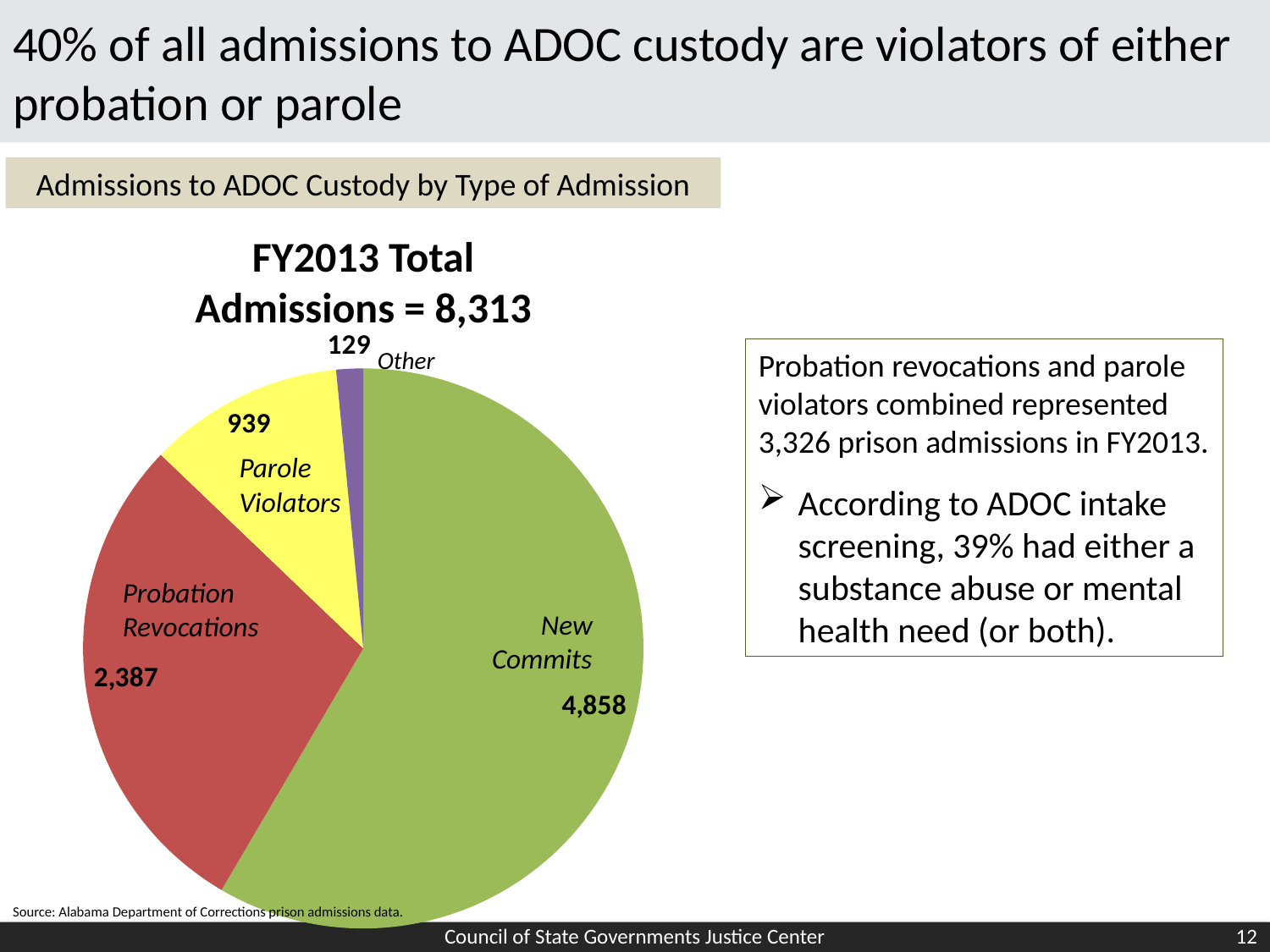
Which is larger, Probation Revocations or Parole Violators? Probation Revocations How many admissions were New Commits in FY2013? 4,858 How many slices does the pie chart have? 4 Which type of admission has the smallest slice of the pie? Other What is the difference between New Commits and Probation Revocations? 2,471 What is the total number of FY2013 admissions shown in the chart title? 8,313 What is the value of the Other slice? 129 How many admissions were Probation Revocations? 2,387 How many admissions were Parole Violators? 939 Which type of admission has the largest slice of the pie? New Commits What type of chart is shown on the slide? Pie chart What colour is the New Commits slice? Green